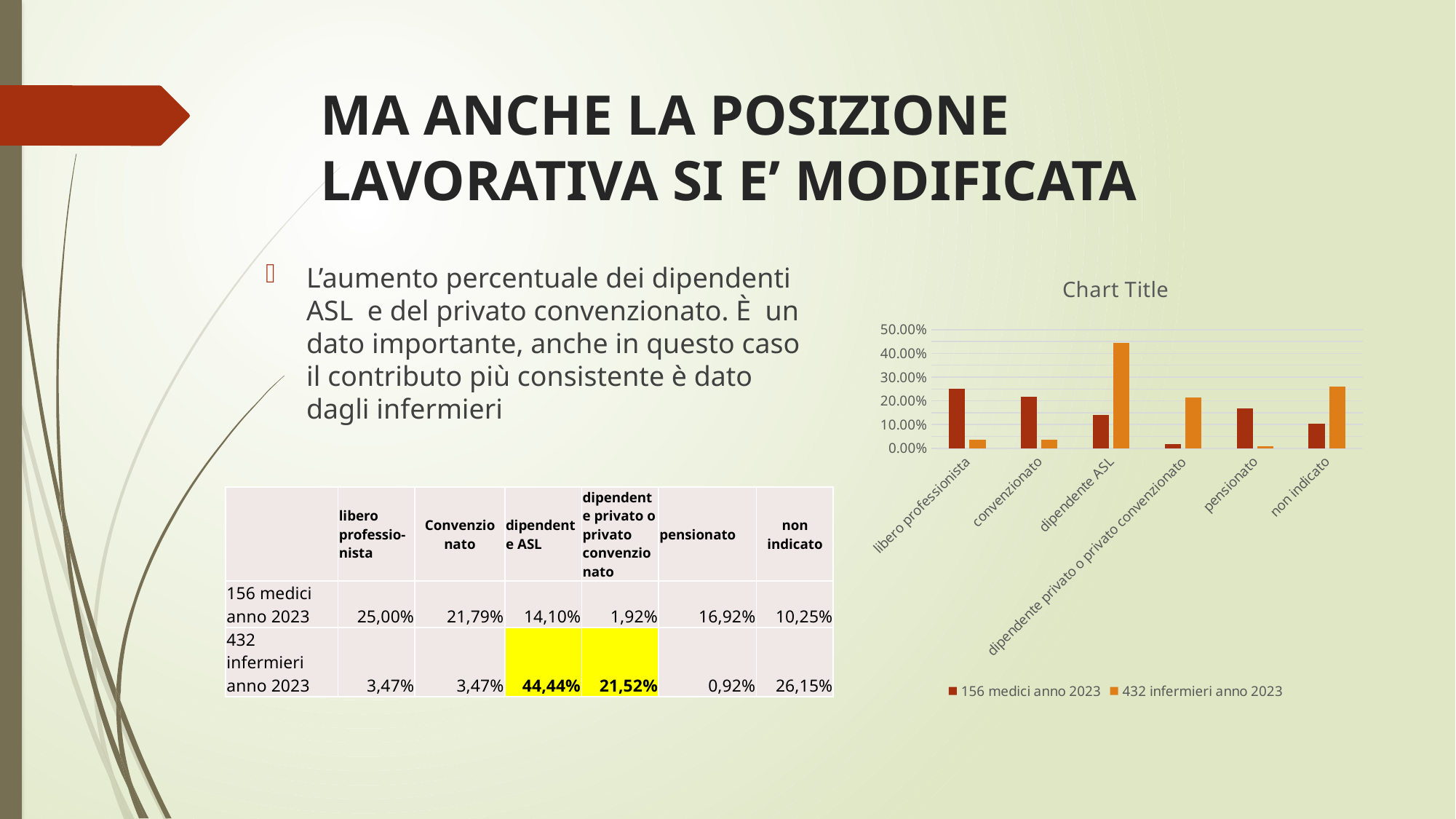
What is the title of the chart? Chart Title What kind of chart is shown on the slide? bar chart For libero professionista, which series has the larger value: 156 medici anno 2023 or 432 infermieri anno 2023? 156 medici anno 2023 How many categories are shown on the x axis of the chart? 6 Which category has the highest value for the series 156 medici anno 2023? libero professionista Is the value for non indicato in the series 432 infermieri anno 2023 greater or less than 20.00%? greater How many series does the chart legend list? 2 Which category has the lowest value for the series 432 infermieri anno 2023? pensionato For dipendente ASL, which series has the larger value: 156 medici anno 2023 or 432 infermieri anno 2023? 432 infermieri anno 2023 Is the value for dipendente ASL in the series 432 infermieri anno 2023 greater or less than 40.00%? greater Which series is shown in orange in the chart? 432 infermieri anno 2023 Which category has the highest value for the series 432 infermieri anno 2023? dipendente ASL